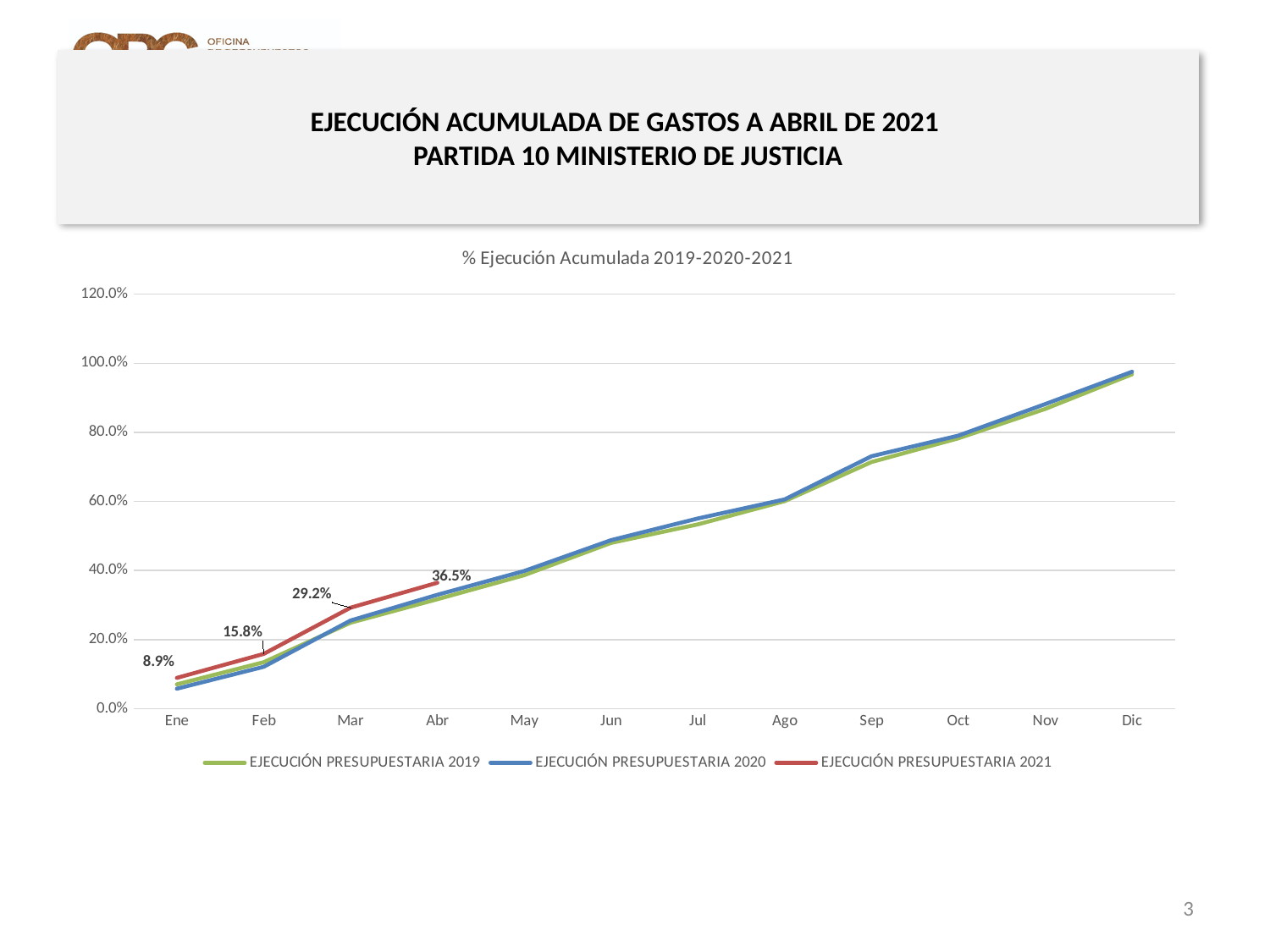
Which series is drawn in red? EJECUCIÓN PRESUPUESTARIA 2021 How many months are shown on the x axis? 12 Do the values for EJECUCIÓN PRESUPUESTARIA 2020 rise or fall from Ene to Dic? Rise How many series does the legend list? 3 Is the value for EJECUCIÓN PRESUPUESTARIA 2020 in Dic greater or less than 80.0%? greater What is the value for EJECUCIÓN PRESUPUESTARIA 2021 in Abr? 36.5% What is the value for EJECUCIÓN PRESUPUESTARIA 2021 in Ene? 8.9% What is the value for EJECUCIÓN PRESUPUESTARIA 2021 in Mar? 29.2% What kind of chart is shown on the slide? Line chart What is the difference between the EJECUCIÓN PRESUPUESTARIA 2021 values for Abr and Mar? 7.3% What is the title of the chart? % Ejecución Acumulada 2019-2020-2021 What is the value for EJECUCIÓN PRESUPUESTARIA 2021 in Feb? 15.8%